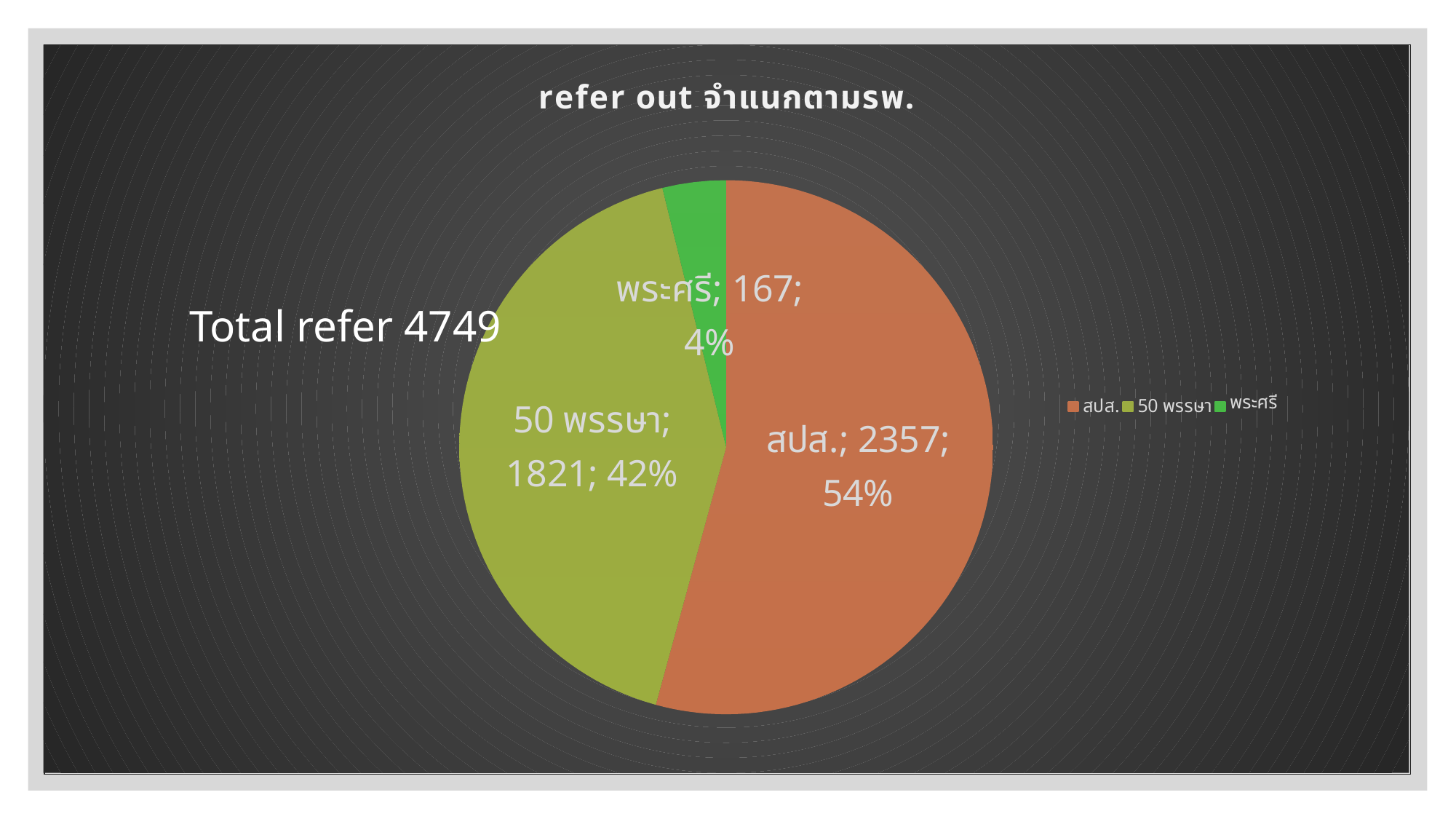
What is the value for พระศรี? 167 Which category has the largest slice? สปส. What is the value for สปส.? 2357 What is the value for 50 พรรษา? 1821 What share of the pie does พระศรี represent? 4% Which category has the smallest slice? พระศรี What type of chart is shown on the slide? pie chart What is the title of the chart? refer out จำแนกตามรพ. What share of the pie does 50 พรรษา represent? 42% What share of the pie does สปส. represent? 54% How many slices does the pie chart have? 3 What is the difference between the values for สปส. and 50 พรรษา? 536